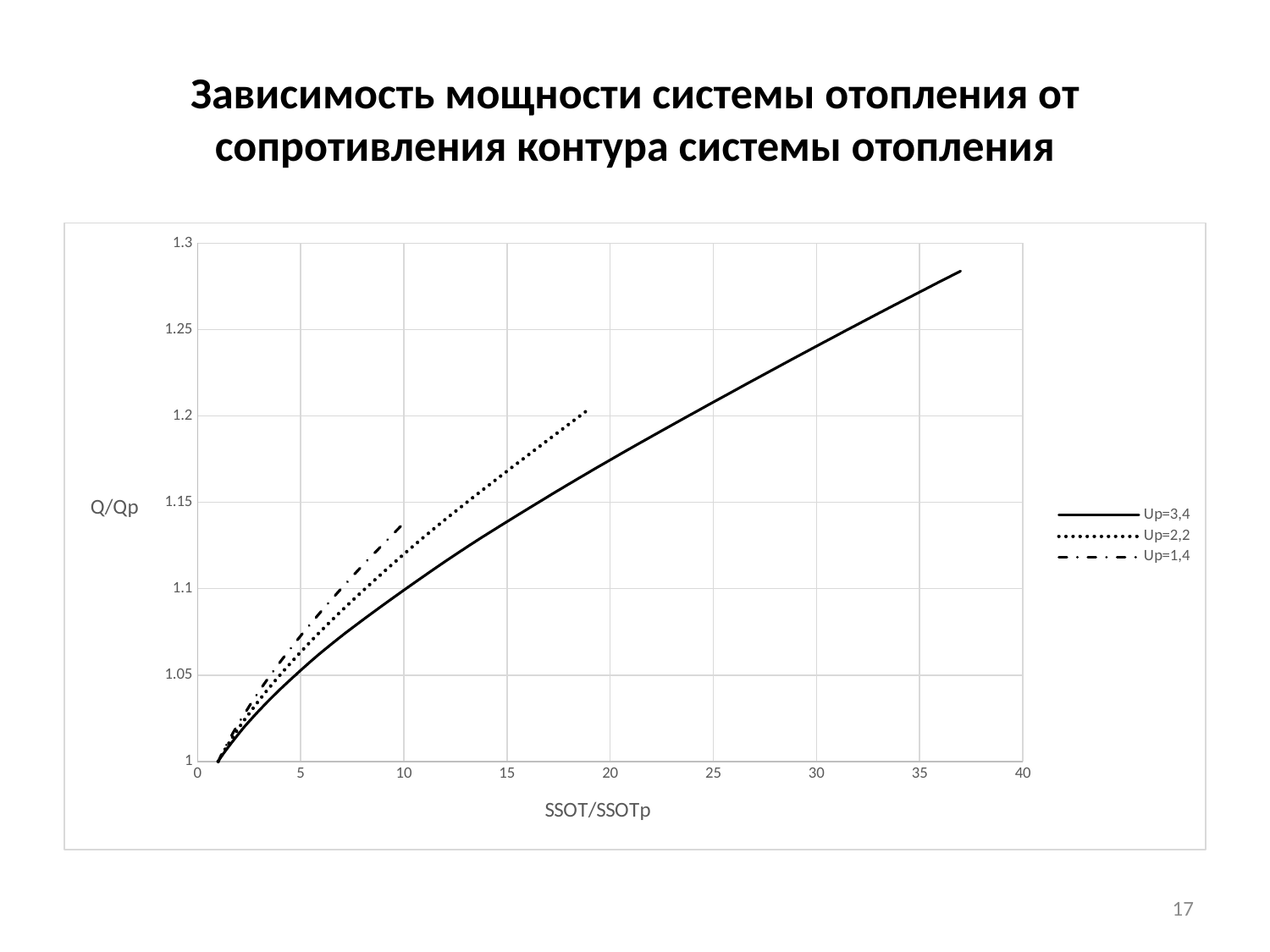
Which series is drawn with a dotted line? Up=2,2 How many series does the legend list? 3 Which series extends furthest along the x axis? Up=3,4 Is the value of the Up=3,4 series at SSOT/SSOTp = 20 greater or less than 1.15? greater What is the title of the chart? Зависимость мощности системы отопления от сопротивления контура системы отопления Is the value of the Up=2,2 series at SSOT/SSOTp = 10 greater or less than 1.1? greater What kind of chart is shown on the slide? line chart Is the value of the Up=3,4 series at its right-hand end (near SSOT/SSOTp = 37) greater or less than 1.25? greater What is the label of the x axis? SSOT/SSOTp Do the values of the Up=3,4 series rise or fall as SSOT/SSOTp increases? rise At SSOT/SSOTp = 5, which series has the higher Q/Qp value, Up=1,4 or Up=3,4? Up=1,4